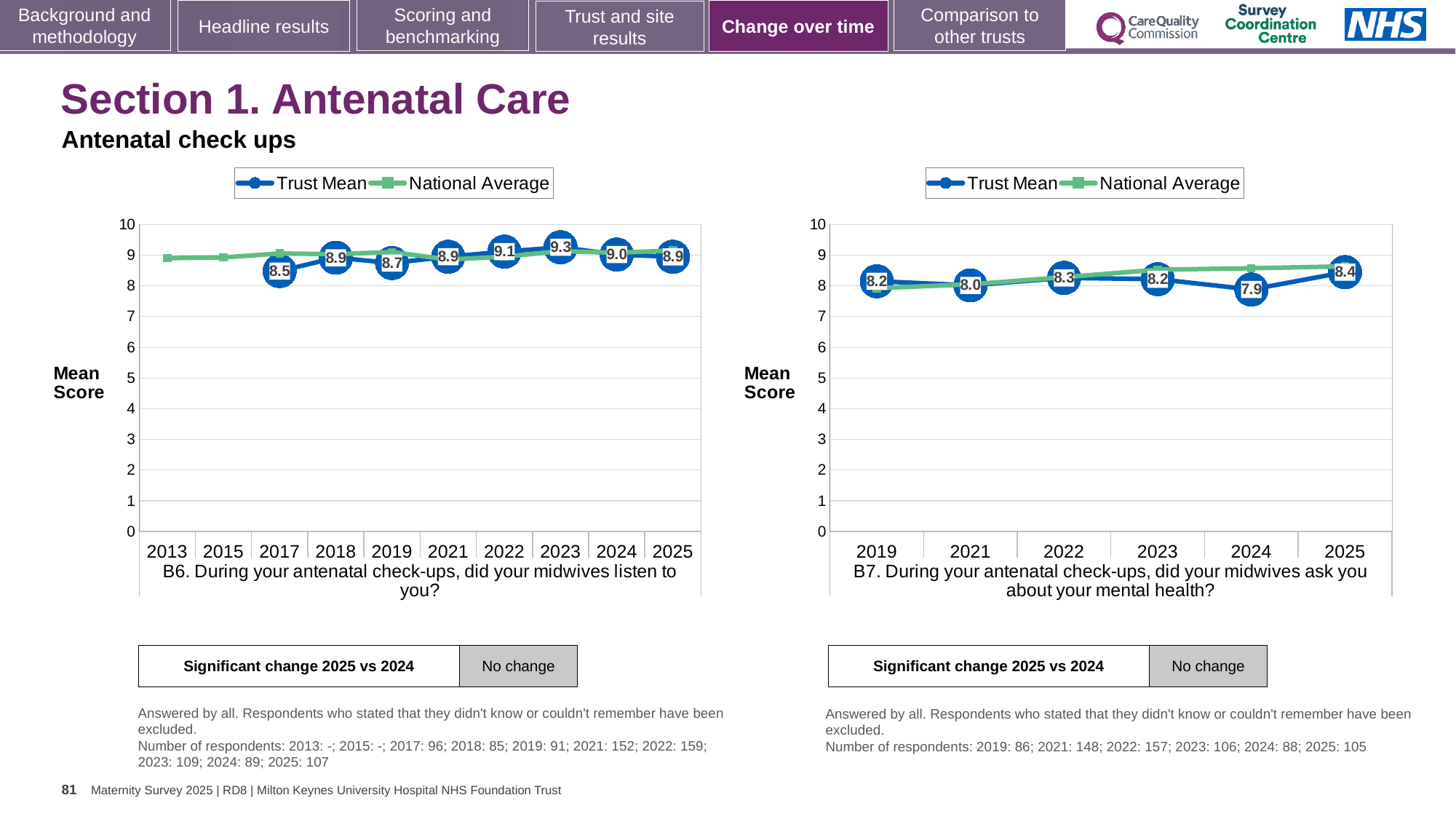
In the B7 chart (right), what is the Trust Mean for 2024? 7.9 In the B7 chart (right), is the Trust Mean for 2025 larger than the Trust Mean for 2021? Yes In the B6 chart (left), what is the Trust Mean for 2023? 9.3 In the B7 chart (right), which year has the lowest Trust Mean? 2024 In the B6 chart (left), which year has the highest Trust Mean? 2023 What kind of chart is the B6 chart (left)? Line chart In the B7 chart (right), which year has the highest Trust Mean? 2025 How many years are shown on the x axis of the B7 chart (right)? 6 In the B6 chart (left), what is the Trust Mean for 2017? 8.5 In the B6 chart (left), what is the difference between the Trust Mean in 2023 and in 2025? 0.4 How many series does the legend of the B6 chart (left) list? 2 In the B6 chart (left), which year has the lowest labelled Trust Mean? 2017